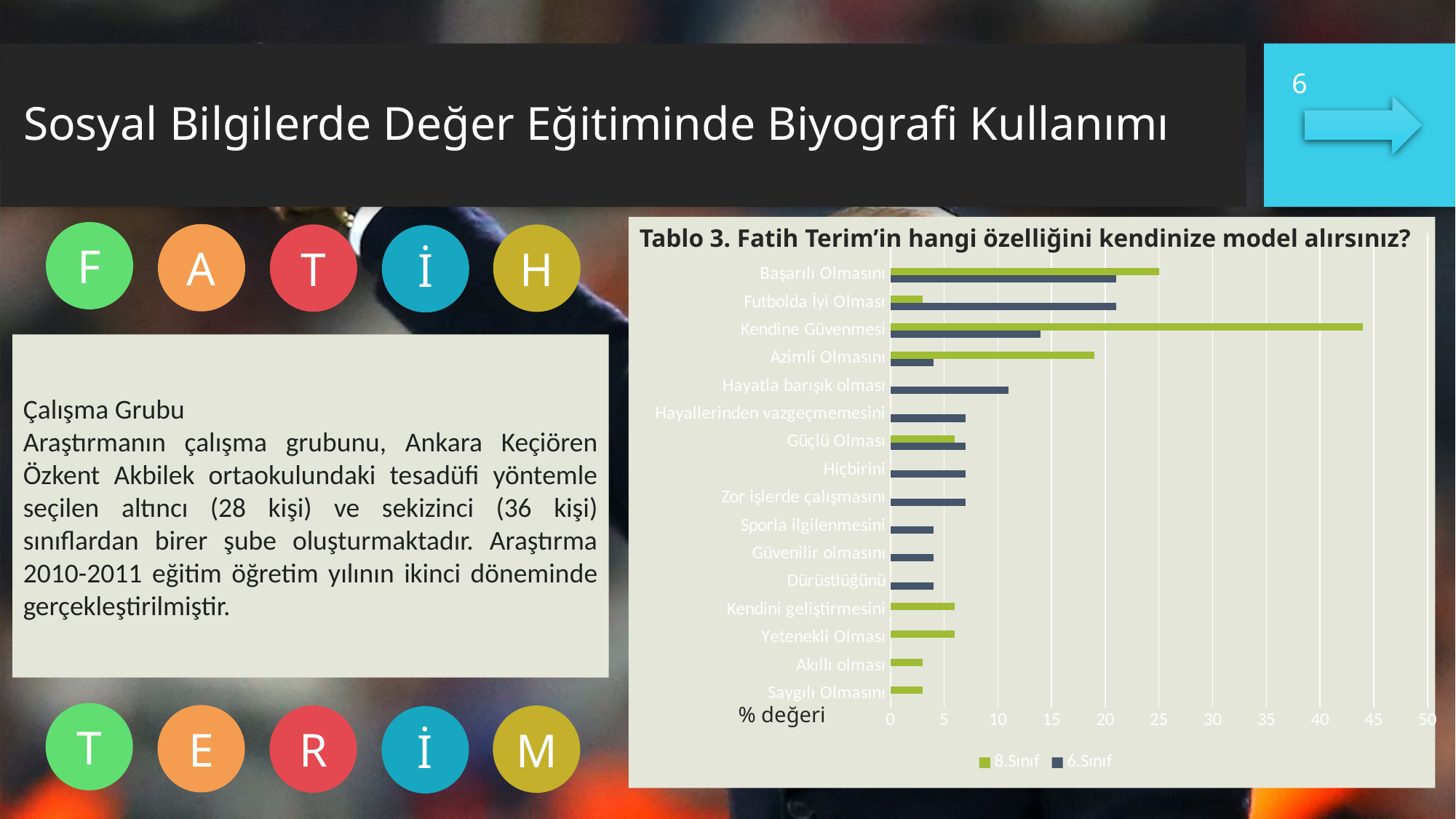
For Futbolda İyi Olması, which series has the larger value, 8.Sınıf or 6.Sınıf? 6.Sınıf Is the 8.Sınıf value for Kendine Güvenmesi greater or less than 40? greater For Kendine Güvenmesi, which series has the larger value, 8.Sınıf or 6.Sınıf? 8.Sınıf Which category has the highest 8.Sınıf value? Kendine Güvenmesi Which series is shown in green in the chart legend? 8.Sınıf How many series does the chart legend list? 2 How many categories are plotted on the chart? 16 Is the 8.Sınıf value for Başarılı Olmasını greater or less than 20? greater What is the title of the chart? Tablo 3. Fatih Terim'in hangi özelliğini kendinize model alırsınız? Is the 8.Sınıf value for Futbolda İyi Olması greater or less than 5? less What kind of chart is shown on the slide? bar chart